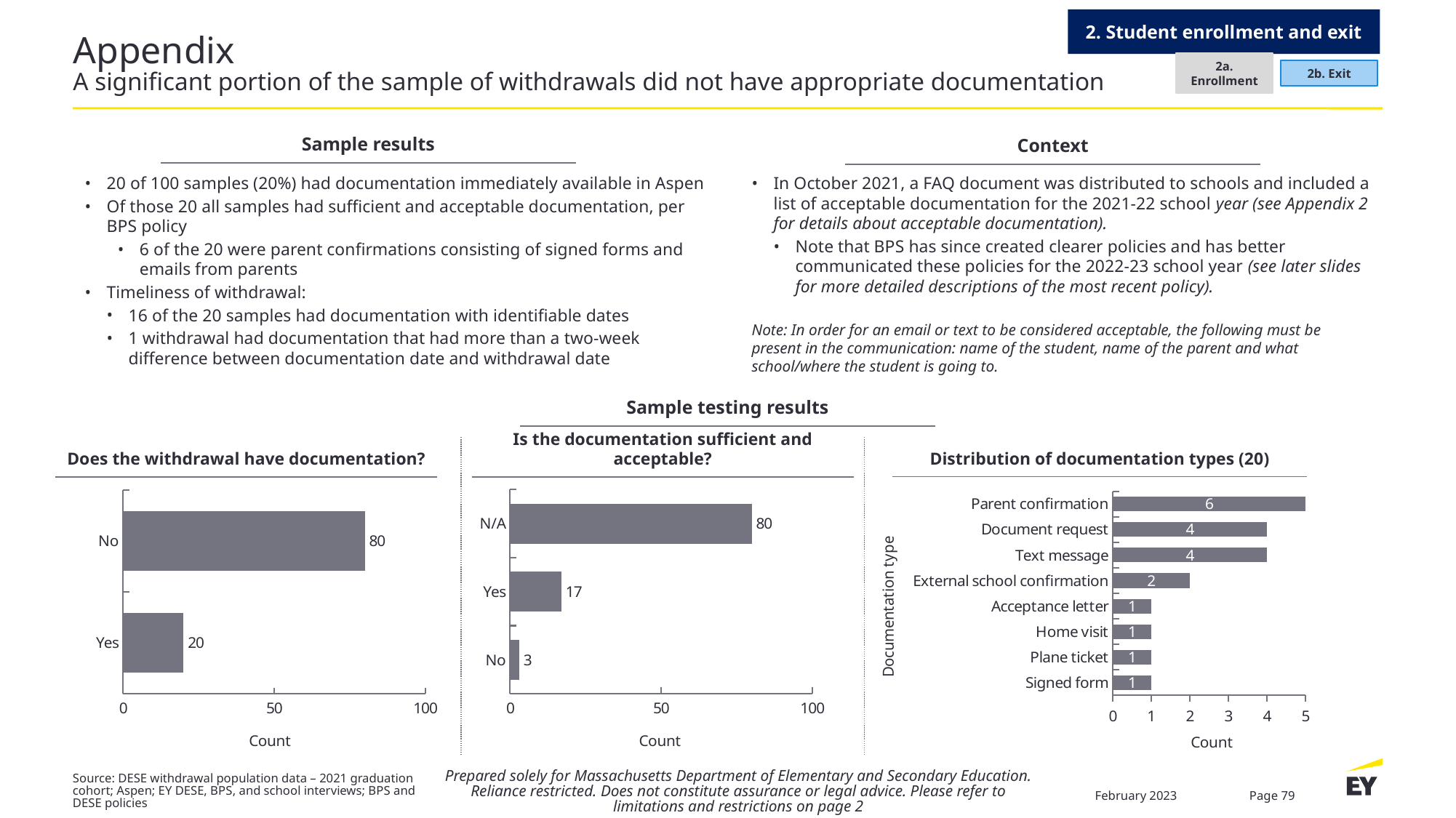
In the chart 'Is the documentation sufficient and acceptable?', what is the count for Yes? 17 In the chart 'Does the withdrawal have documentation?', what is the count for Yes? 20 In the chart 'Distribution of documentation types (20)', what is the difference between the counts for Parent confirmation and Text message? 2 What type of chart is 'Does the withdrawal have documentation?'? Bar chart In the chart 'Distribution of documentation types (20)', which documentation type has the highest count? Parent confirmation In the chart 'Distribution of documentation types (20)', is the count for Document request larger or smaller than the count for External school confirmation? larger In the chart 'Distribution of documentation types (20)', what is the count for Parent confirmation? 6 In the chart 'Distribution of documentation types (20)', how many documentation types are listed? 8 In the chart 'Does the withdrawal have documentation?', what is the count for No? 80 In the chart 'Is the documentation sufficient and acceptable?', how many categories are shown? 3 In the chart 'Is the documentation sufficient and acceptable?', which category has the lowest count? No In the chart 'Does the withdrawal have documentation?', what is the difference between the No and Yes counts? 60